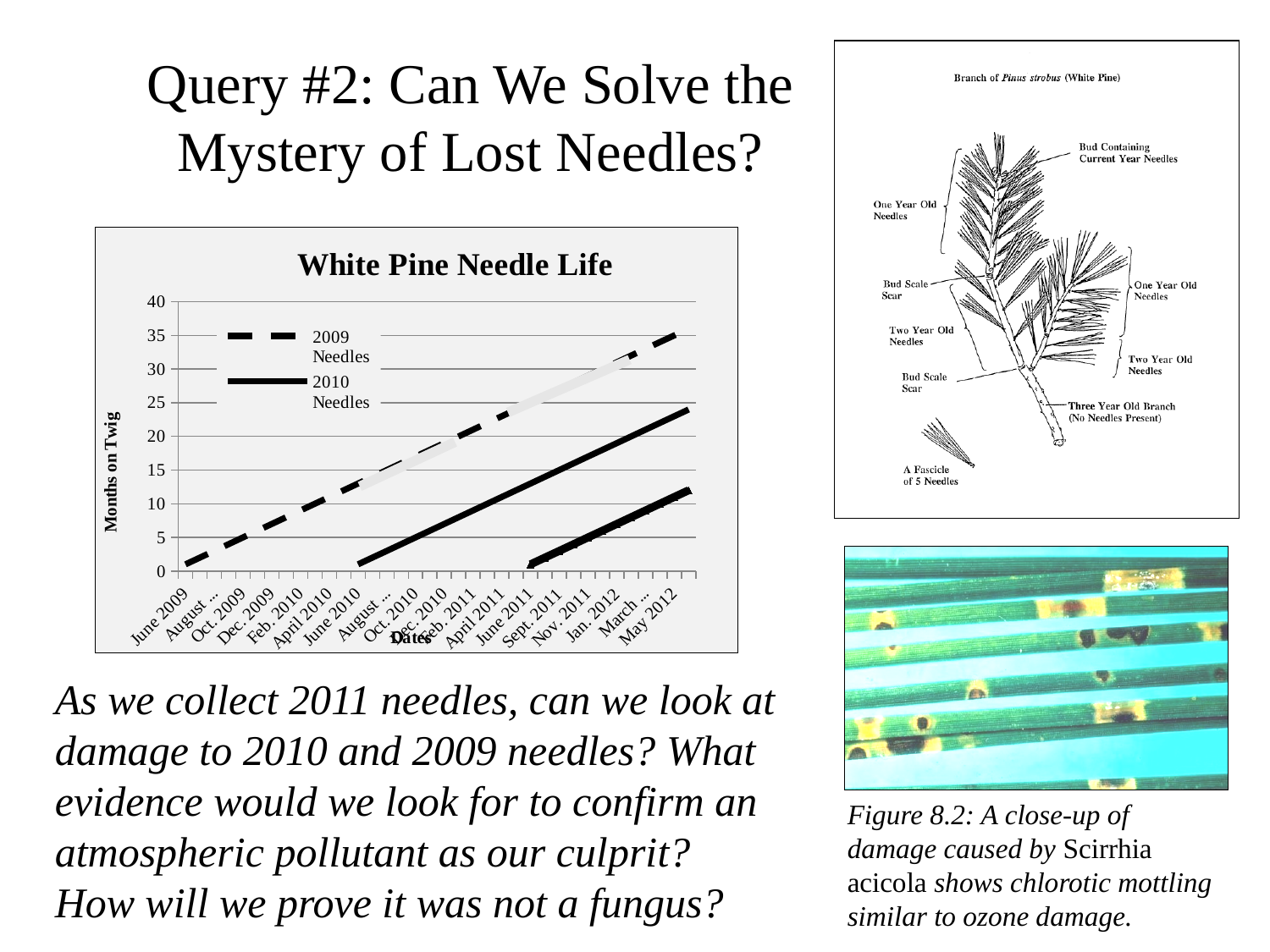
Do the values for 2010 Needles rise or fall along the x axis? rise Is the value for 2010 Needles at May 2012 greater or less than 20? greater Is the value for 2009 Needles at May 2012 greater or less than 30? greater What kind of chart is the White Pine Needle Life chart? line chart How many series does the legend of the White Pine Needle Life chart list? 2 Which series has the highest value at the right end of the chart? 2009 Needles Is the value for 2009 Needles at June 2009 greater or less than 5? less At May 2012, which series has the larger value, 2009 Needles or 2010 Needles? 2009 Needles What is the label of the y axis on the White Pine Needle Life chart? Months on Twig What is the title of the chart on the slide? White Pine Needle Life Do the values for 2009 Needles rise or fall along the x axis? rise